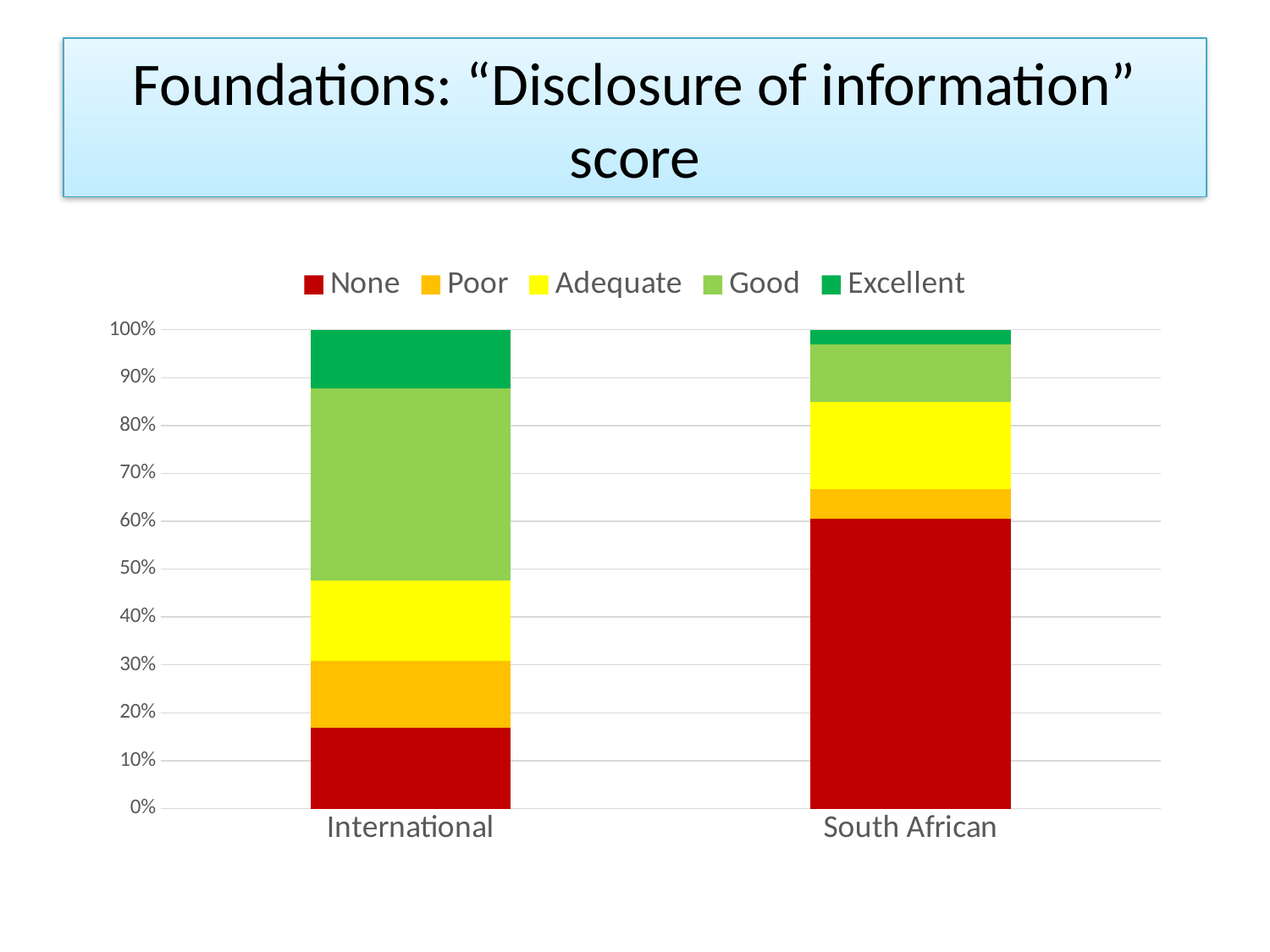
Which category has the larger 'None' share, International or South African? South African Is the 'None' share for South African greater or less than 50%? greater Is the 'None' share for International greater or less than 20%? less Is the 'Good' share for International greater or less than 30%? greater What kind of chart is shown on the slide? Stacked bar chart How many categories are shown on the x axis? 2 What is the title of the slide containing the chart? Foundations: "Disclosure of information" score Which category has the larger 'Good' share, International or South African? International What is the total height of the South African stacked bar? 100% Which series is shown in red in the legend? None How many series does the legend list? 5